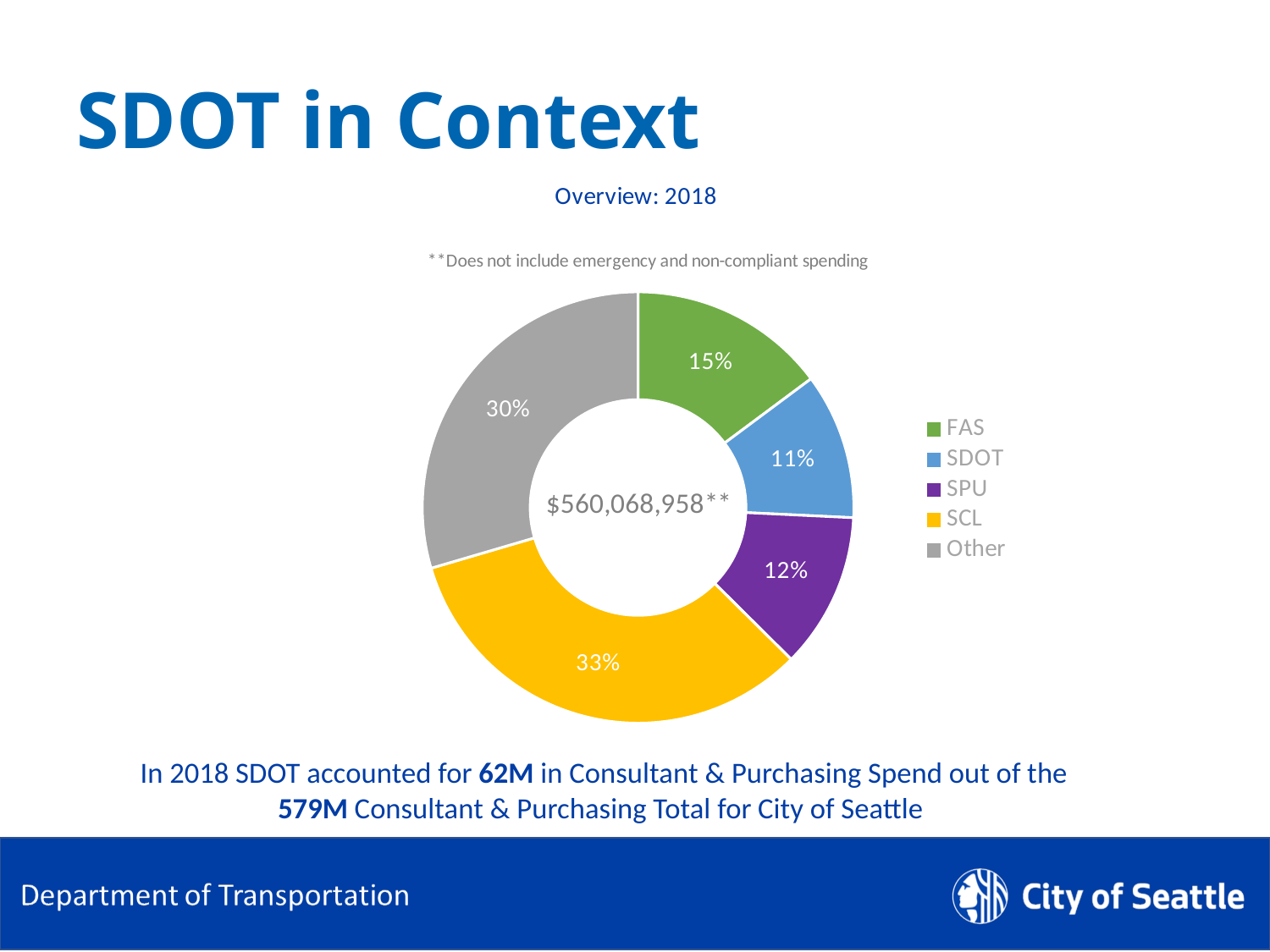
What share of the chart does Other account for? 30% Which category has the smallest share of the chart? SDOT What kind of chart is shown on the slide? Pie chart (doughnut) Which category has the largest share of the chart? SCL What is the difference in percentage points between the SCL share and the SDOT share? 22 percentage points What share of the chart does SCL account for? 33% Which has a larger share, FAS or SPU? FAS What share of the chart does SDOT account for? 11% What total value is printed in the centre of the chart? $560,068,958** How many categories does the legend list? 5